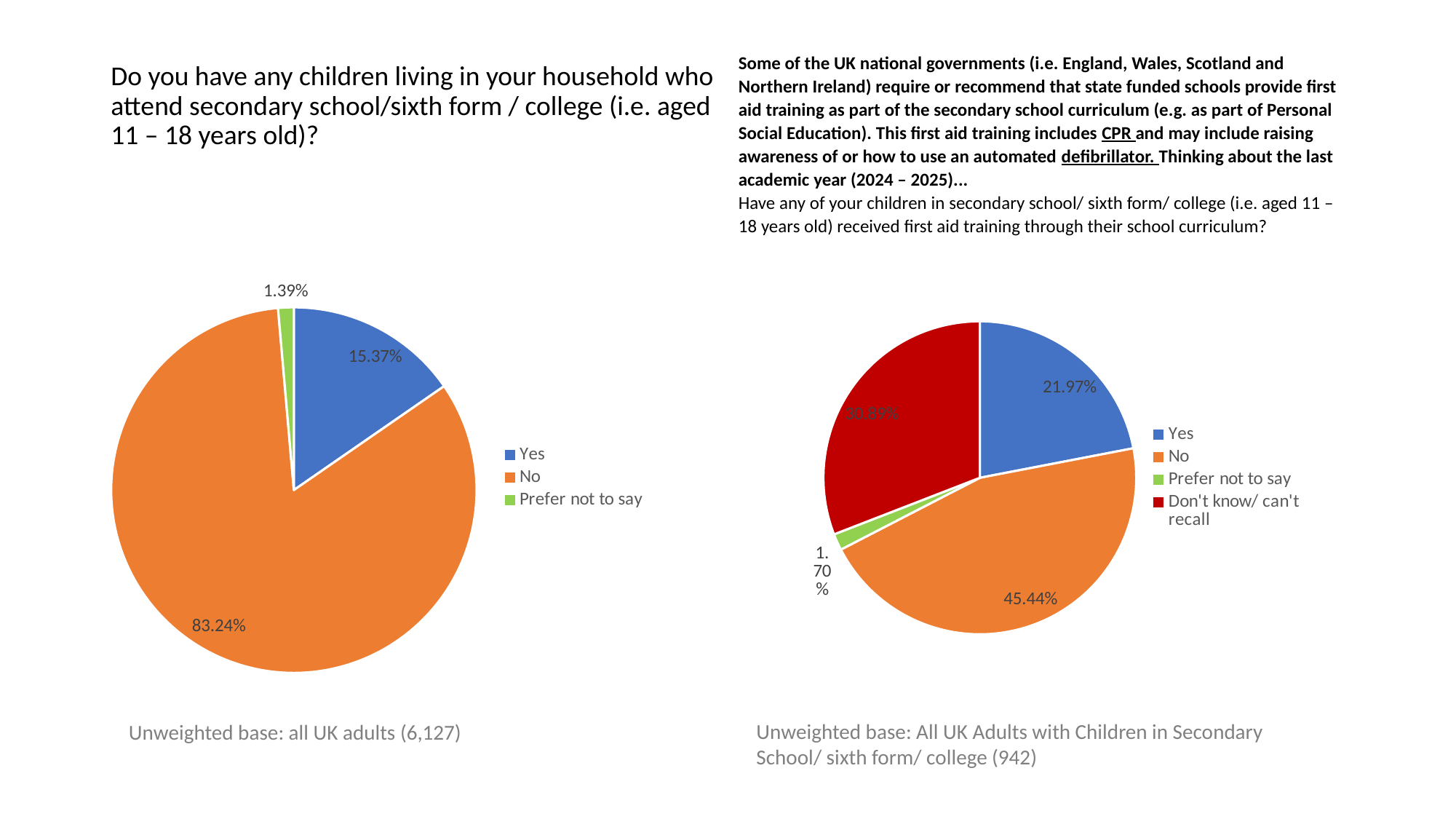
In the right pie chart, what percentage of respondents answered "No"? 45.44% In the left pie chart, which response has the smallest share? Prefer not to say In the left pie chart, which response has the largest share? No In the left pie chart, what is the difference between the "No" and "Yes" shares? 67.87% In the right pie chart, which response has the largest share? No In the right pie chart, which is larger: the "Don't know/ can't recall" share or the "Yes" share? Don't know/ can't recall What type of chart is used on the left side of the slide? Pie chart In the left pie chart, what percentage of respondents answered "No"? 83.24% In the left pie chart, what percentage of respondents chose "Prefer not to say"? 1.39% In the right pie chart, what percentage of respondents answered "Yes"? 21.97% In the left pie chart, what percentage of respondents answered "Yes"? 15.37% How many categories does the legend of the right pie chart list? 4